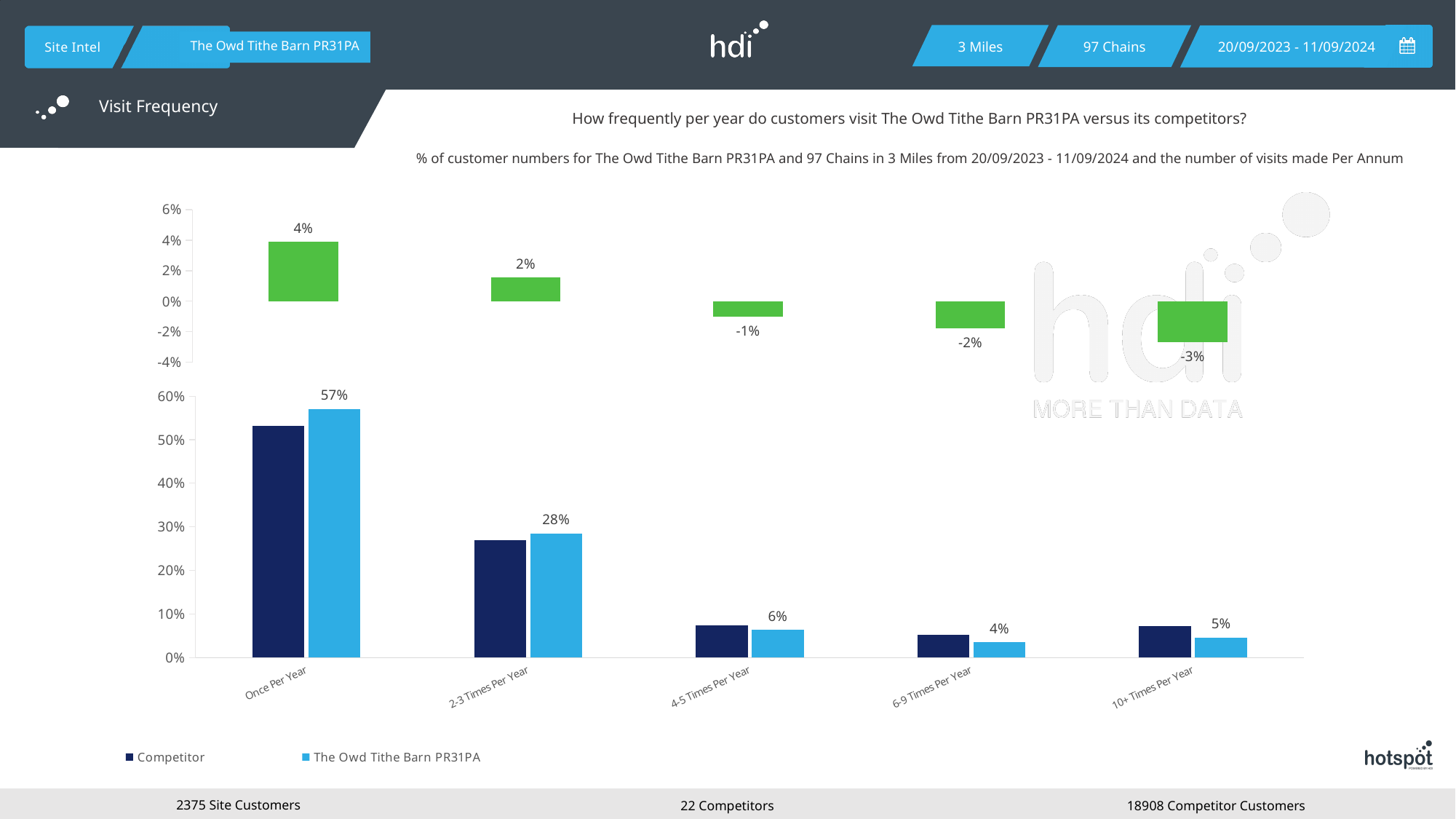
In the top chart, which category has the highest value? Once Per Year In the bottom chart, what is the value for The Owd Tithe Barn PR31PA for Once Per Year? 57% In the top chart, what is the value shown for 10+ Times Per Year? -3% In the top chart, what is the value shown for 4-5 Times Per Year? -1% In the bottom chart, what is the value for The Owd Tithe Barn PR31PA for 10+ Times Per Year? 5% In the bottom chart, which is larger for Once Per Year: the Competitor bar or The Owd Tithe Barn PR31PA bar? The Owd Tithe Barn PR31PA In the bottom chart, is the Competitor value for Once Per Year greater or less than 50%? greater How many categories are shown on the x axis of the bottom chart? 5 How many series does the legend of the bottom chart list? 2 In the top chart, which category has the lowest value? 10+ Times Per Year In the bottom chart, what is the value for The Owd Tithe Barn PR31PA for 2-3 Times Per Year? 28% In the bottom chart, what is the difference between The Owd Tithe Barn PR31PA values for Once Per Year and 2-3 Times Per Year? 29%